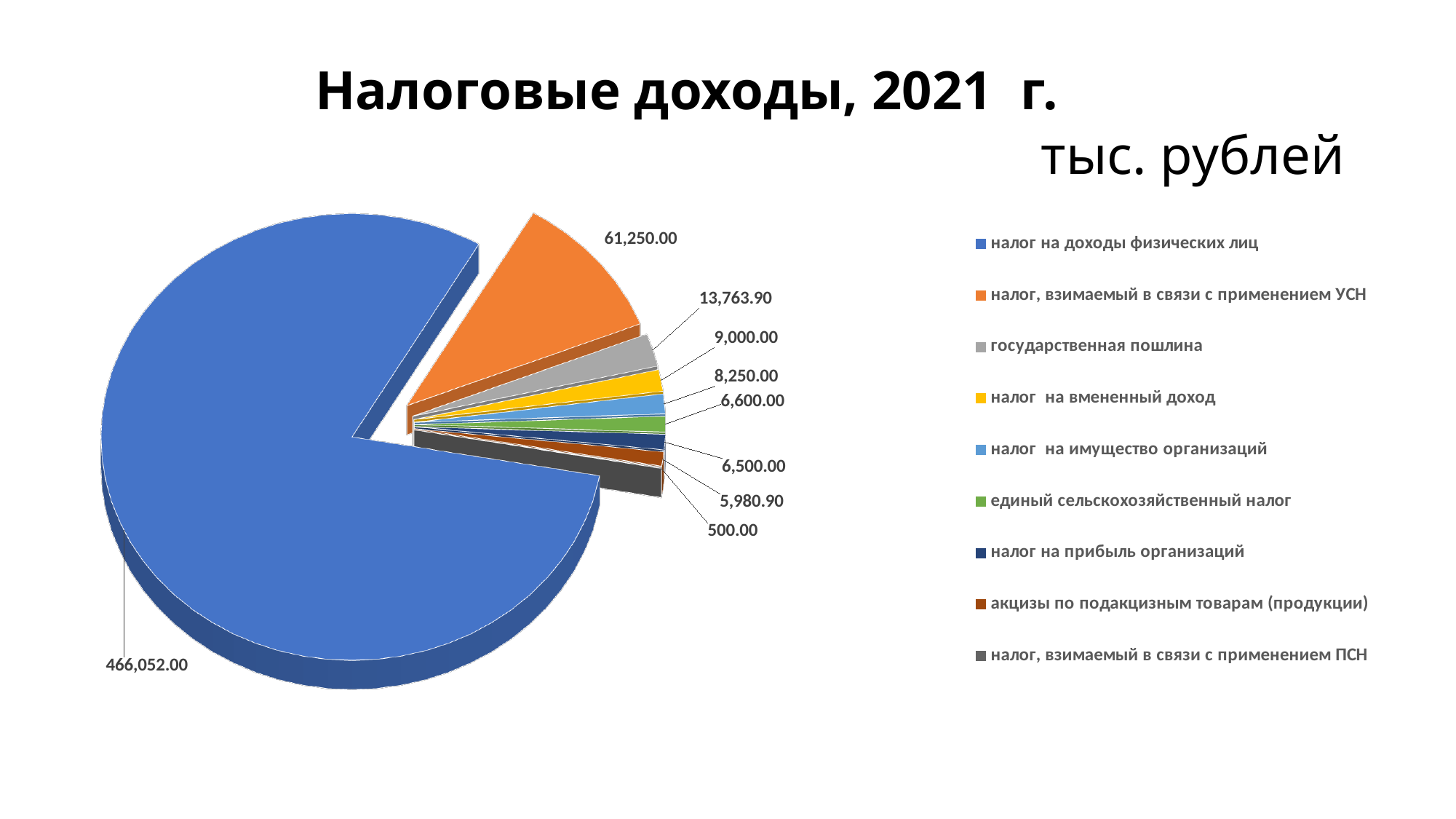
What is the value for государственная пошлина? 13,763.90 What is the title of the chart? Налоговые доходы, 2021 г. Which category has the smallest value? налог, взимаемый в связи с применением ПСН How many categories does the legend list? 9 What is the difference between the values for налог, взимаемый в связи с применением УСН and государственная пошлина? 47,486.10 What is the value for налог на доходы физических лиц? 466,052.00 What is the value for единый сельскохозяйственный налог? 6,600.00 What type of chart is shown on the slide? pie chart What is the value for налог, взимаемый в связи с применением УСН? 61,250.00 What is the value for налог на вмененный доход? 9,000.00 In what units are the values on the chart given? тыс. рублей Which category has the largest value? налог на доходы физических лиц